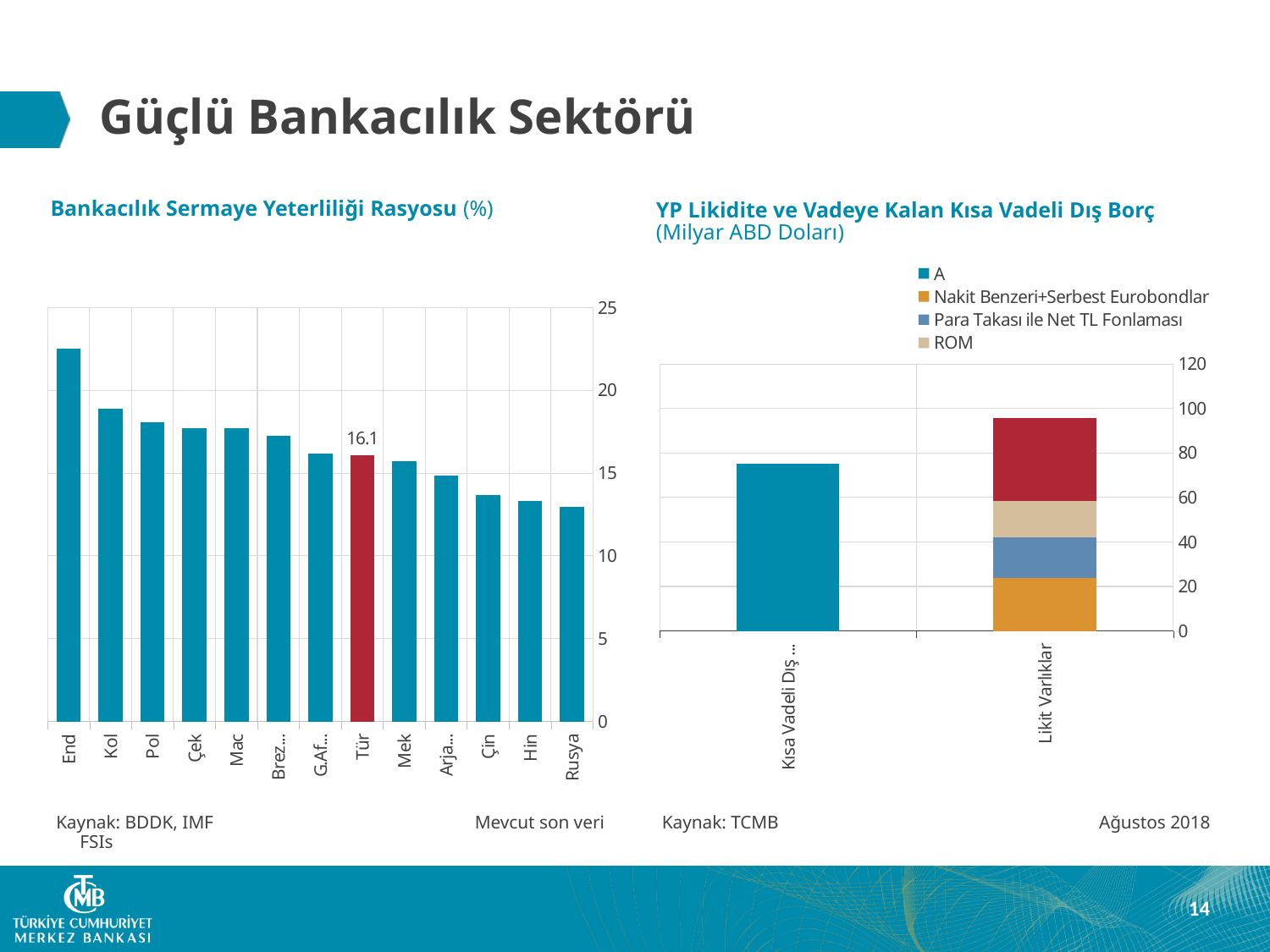
In the chart titled 'Bankacılık Sermaye Yeterliliği Rasyosu (%)', what kind of chart is shown? bar chart In the chart titled 'Bankacılık Sermaye Yeterliliği Rasyosu (%)', is the value for End greater or less than 20? greater In the chart titled 'Bankacılık Sermaye Yeterliliği Rasyosu (%)', which country's bar is coloured red? Tür In the chart titled 'YP Likidite ve Vadeye Kalan Kısa Vadeli Dış Borç', which bar is taller, Kısa Vadeli Dış or Likit Varlıklar? Likit Varlıklar In the chart titled 'Bankacılık Sermaye Yeterliliği Rasyosu (%)', which country has the highest value? End In the chart titled 'Bankacılık Sermaye Yeterliliği Rasyosu (%)', what is the value for Tür? 16.1 In the chart titled 'YP Likidite ve Vadeye Kalan Kısa Vadeli Dış Borç', how many series does the legend list? 4 In the chart titled 'YP Likidite ve Vadeye Kalan Kısa Vadeli Dış Borç', is the value for Likit Varlıklar greater or less than 80? greater In the chart titled 'Bankacılık Sermaye Yeterliliği Rasyosu (%)', how many countries are plotted? 13 In the chart titled 'Bankacılık Sermaye Yeterliliği Rasyosu (%)', which is larger, the value for End or the value for Kol? End In the chart titled 'Bankacılık Sermaye Yeterliliği Rasyosu (%)', do the values rise or fall from left to right along the x axis? fall In the chart titled 'Bankacılık Sermaye Yeterliliği Rasyosu (%)', which country has the lowest value? Rusya